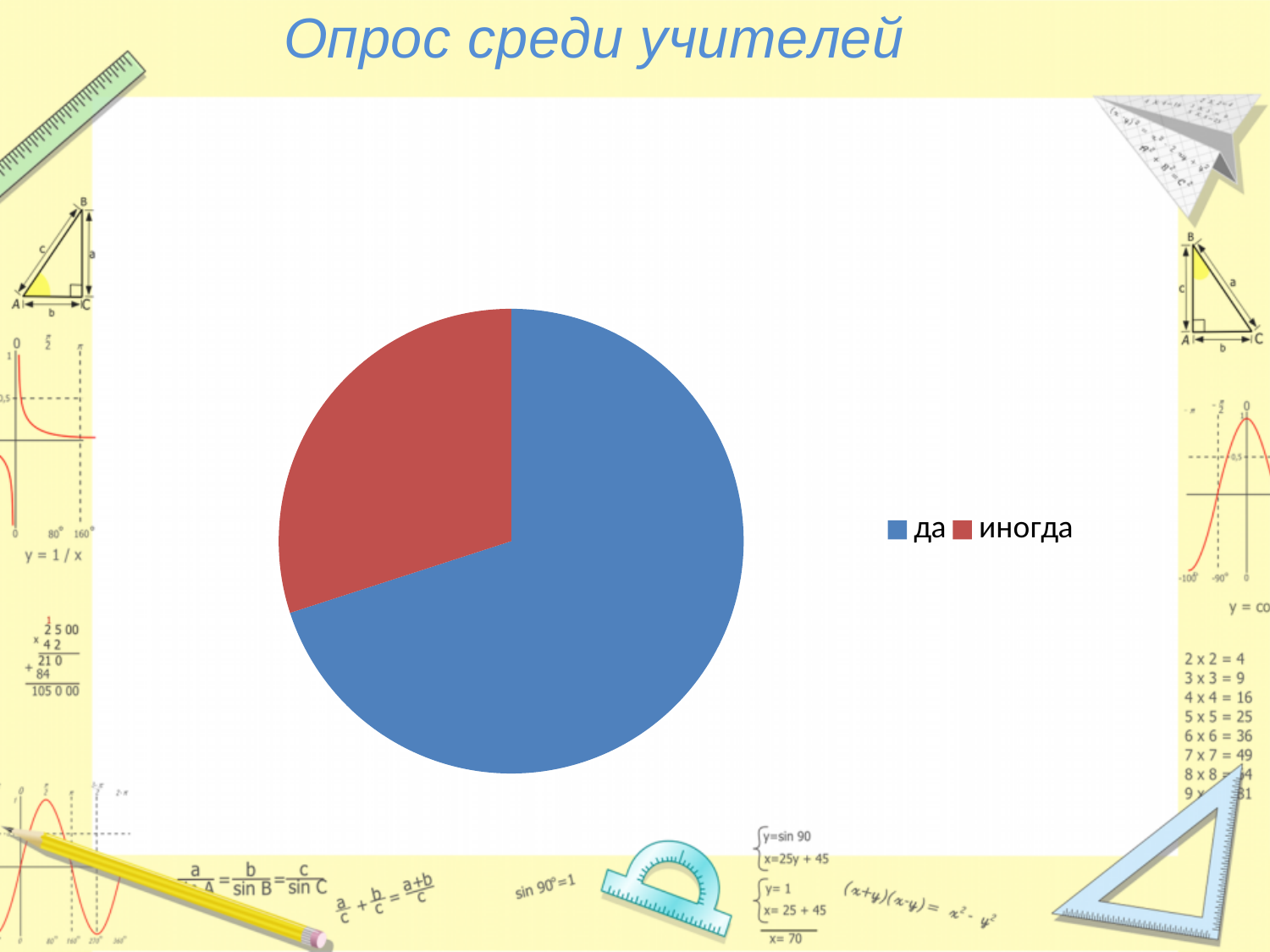
Which slice is larger in the pie chart, "да" or "иногда"? да How many slices does the pie chart have? 2 What colour is the "да" slice in the pie chart? blue Which category has the largest slice in the pie chart? да How many entries does the legend of the pie chart list? 2 What kind of chart is shown on the slide? pie chart What are the two legend entries of the pie chart? да, иногда Which category has the smallest slice in the pie chart? иногда